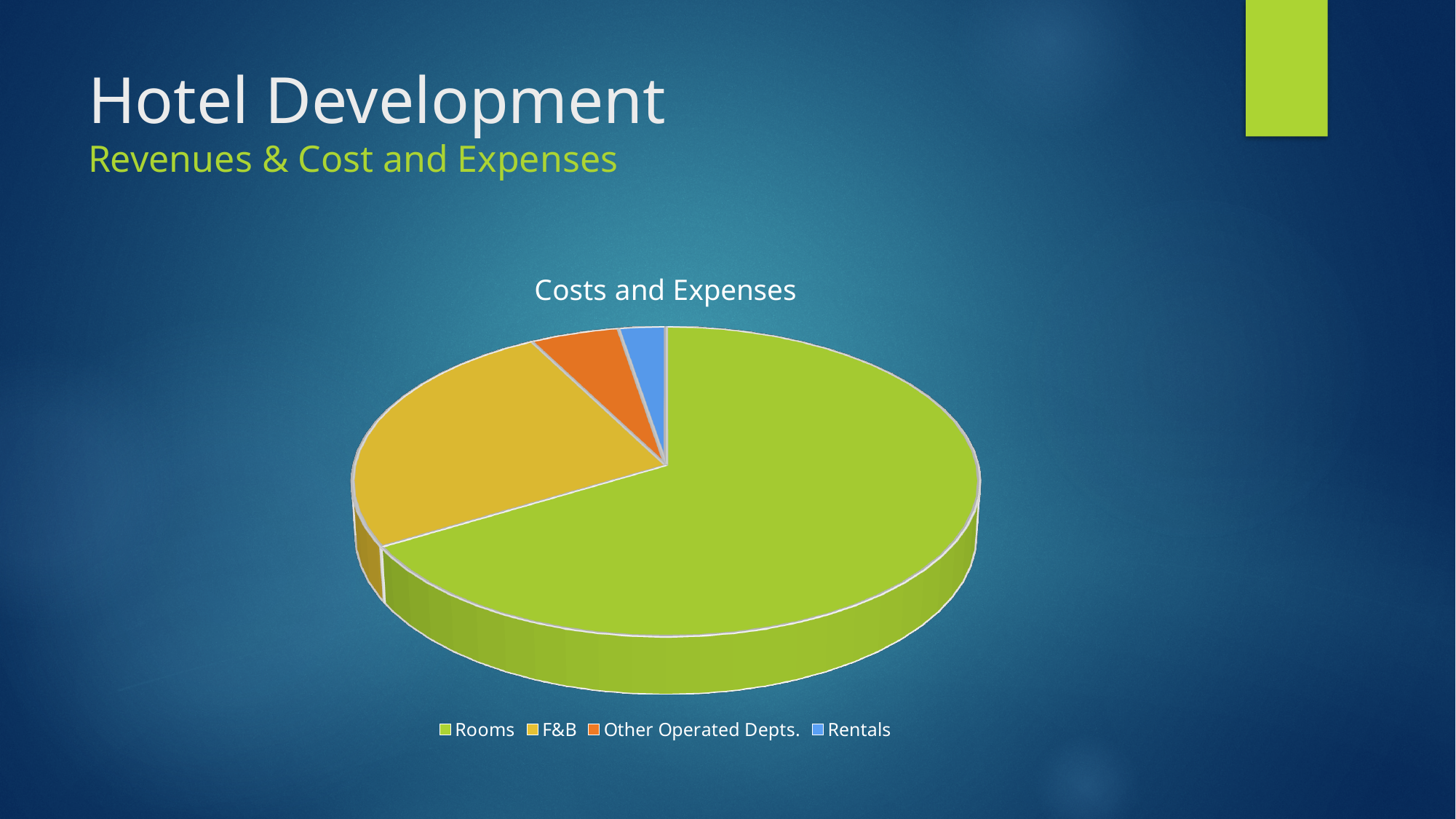
Which category is shown in orange in the pie chart? Other Operated Depts. Which slice is larger, Rooms or F&B? Rooms Which slice is larger, F&B or Other Operated Depts.? F&B What colour is the Rentals slice in the pie chart? Blue Which slice is larger, Other Operated Depts. or Rentals? Other Operated Depts. What kind of chart is shown on the slide? Pie chart Which category has the largest slice of the pie? Rooms Which category is the second-largest slice of the pie? F&B Which category has the smallest slice of the pie? Rentals How many categories (slices) does the pie chart have? 4 What is the title of the chart? Costs and Expenses